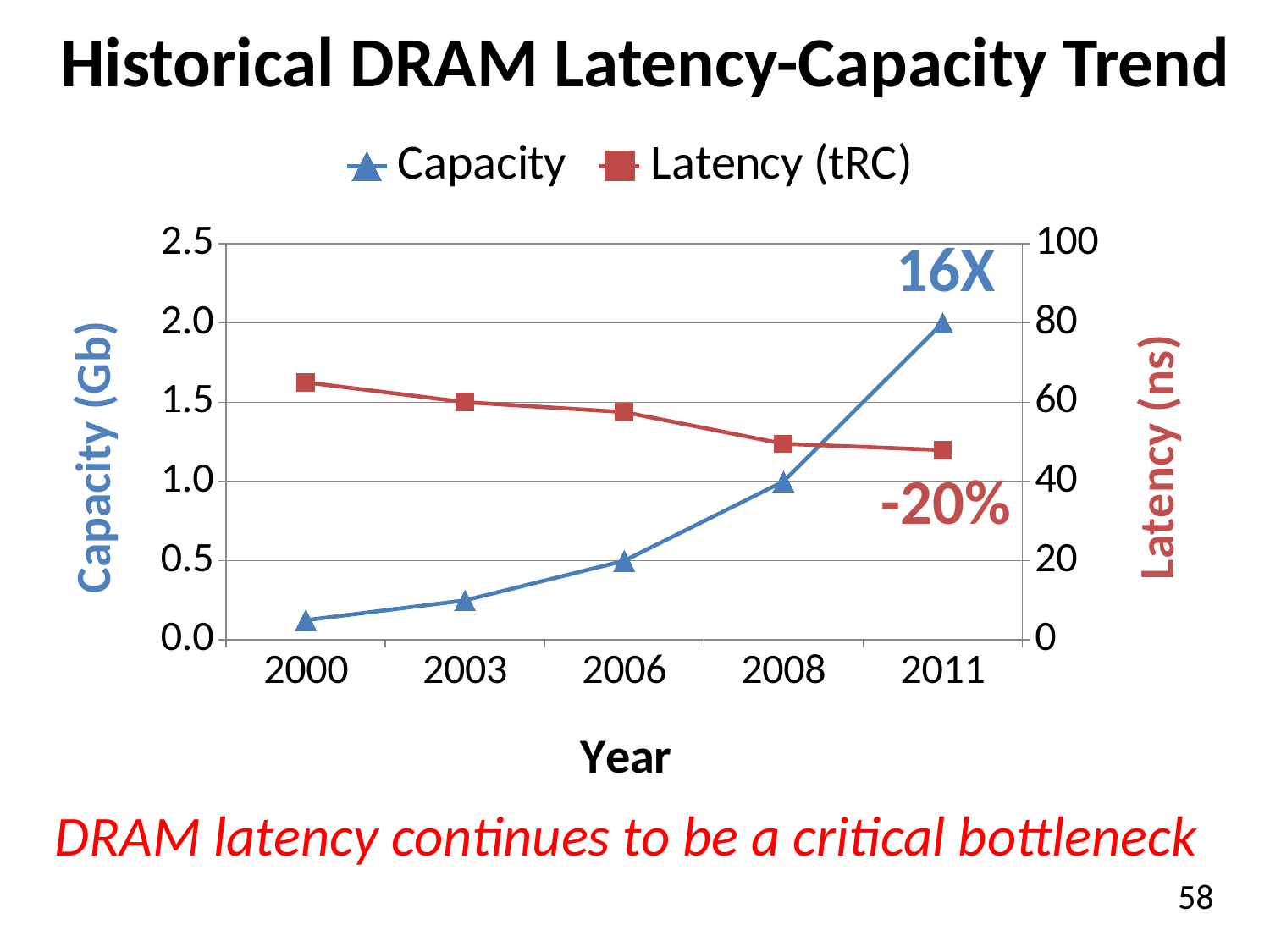
In which year is Capacity highest? 2011 Is the Latency (tRC) value for 2011 greater or less than 60? less How many years are plotted along the x axis? 5 In which year is Latency (tRC) highest? 2000 Is the Latency (tRC) value for 2000 greater or less than 60? greater Does the Latency (tRC) series rise or fall from 2000 to 2011? fall What kind of chart is shown on the slide? line chart Does the Capacity series rise or fall from 2000 to 2011? rise What is the Capacity value for 2011? 2.0 What is the Capacity value for 2008? 1.0 Is the Capacity value for 2006 greater or less than 1.0? less How many series does the legend list? 2